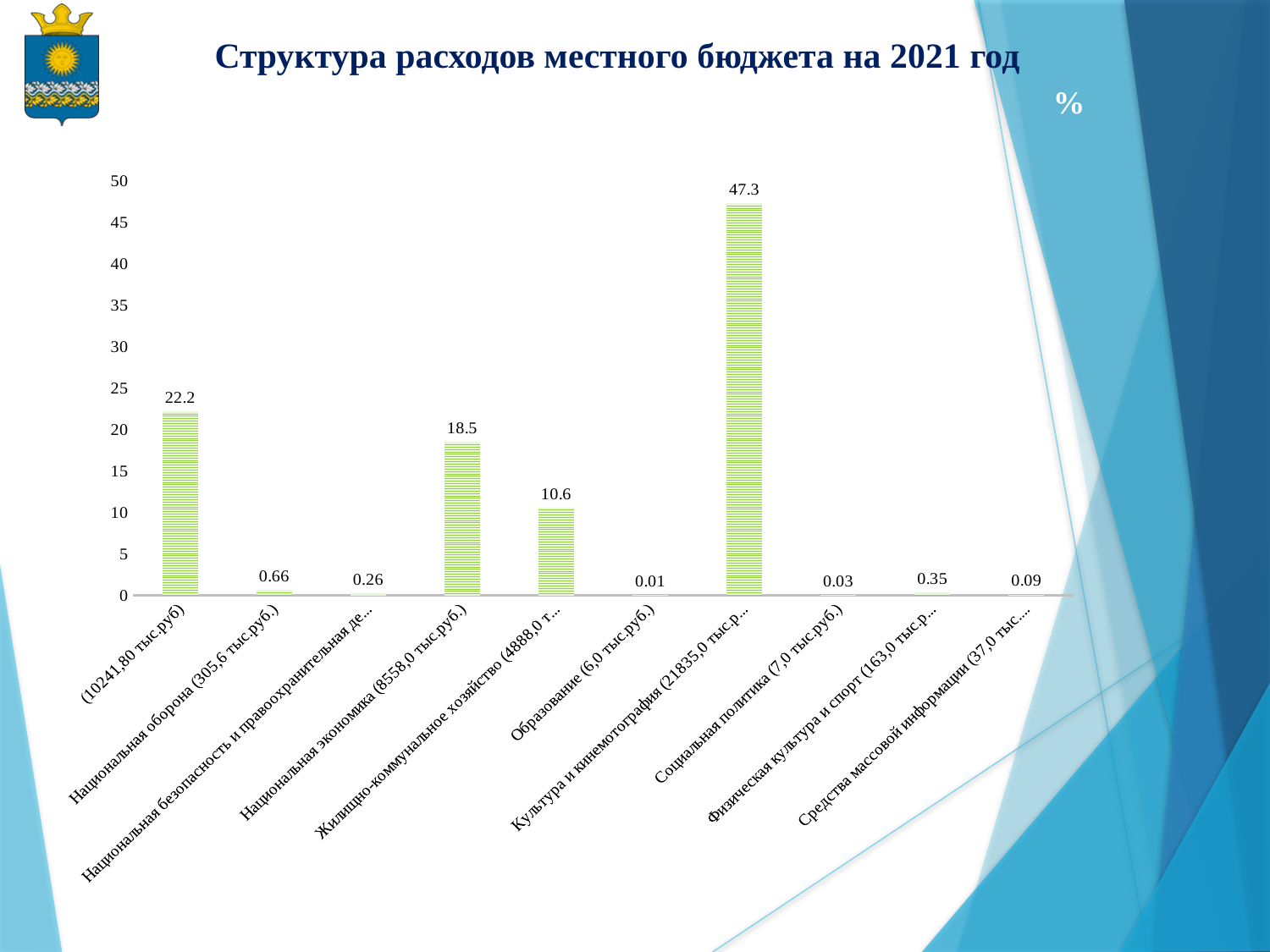
Which category has the highest value? Культура и кинемотография Is the value for Культура и кинемотография greater or less than 45? greater How many categories are shown in the chart? 10 What is the value for Национальная экономика? 18.5 What is the value for Жилищно-коммунальное хозяйство? 10.6 What kind of chart is shown on the slide? bar chart What is the value for Культура и кинемотография? 47.3 What is the value for Национальная оборона? 0.66 Which is larger, the value for Национальная экономика or the value for Жилищно-коммунальное хозяйство? Национальная экономика What is the difference between the values for Культура и кинемотография and Национальная экономика? 28.8 What is the value for Образование? 0.01 Which category has the lowest value? Образование